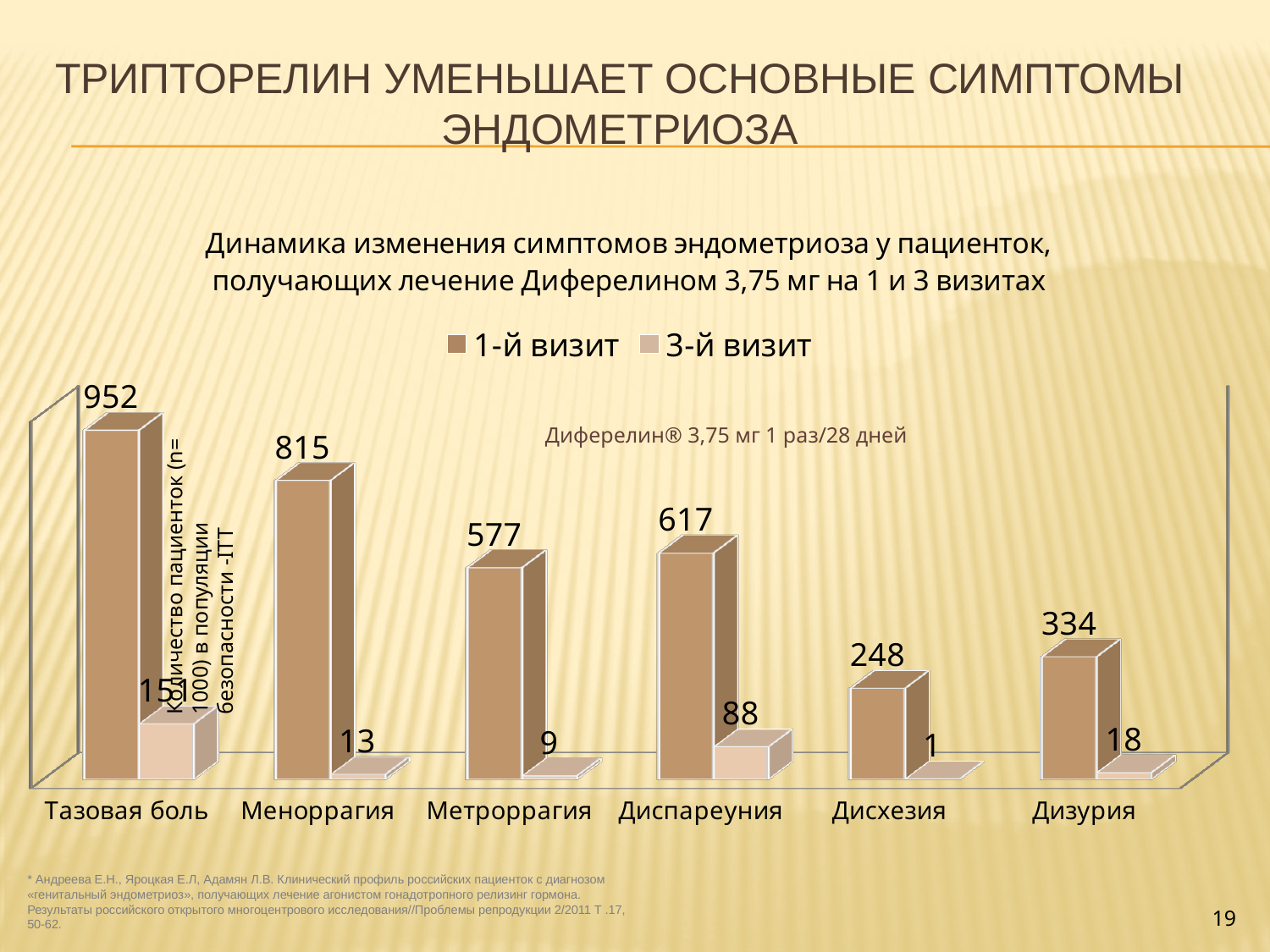
Which category has the highest value for the 1-й визит series? Тазовая боль Which is larger for the 1-й визит series: Диспареуния or Метроррагия? Диспареуния What type of chart is shown on the slide? bar chart How many symptom categories are shown on the x axis? 6 Which category has the lowest value for the 3-й визит series? Дисхезия What is the difference between the 1-й визит and 3-й визит values for Метроррагия? 568 What is the value for Меноррагия at the 1-й визит? 815 What is the value for Дисхезия at the 1-й визит? 248 What are the two legend entries of the chart? 1-й визит and 3-й визит How many series does the legend list? 2 What is the value for Дизурия at the 3-й визит? 18 What is the value for Диспареуния at the 3-й визит? 88